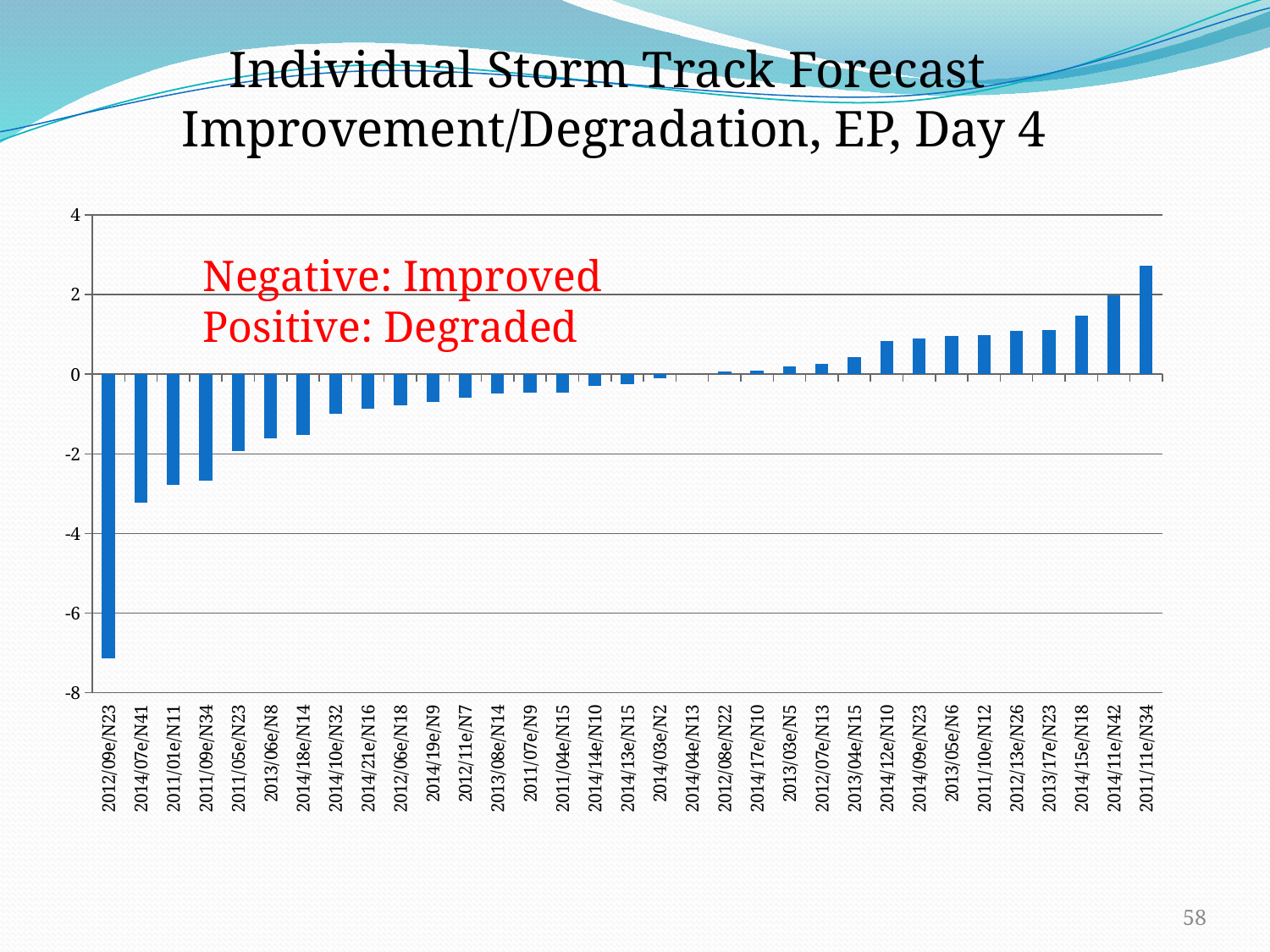
What kind of chart is shown on the slide? bar chart Is the value for 2013/06e/N8 greater or less than -2? greater Is the value for 2014/07e/N41 greater or less than -2? less Is the value for 2012/09e/N23 greater or less than -6? less Which storm has the lowest (most negative) value? 2012/09e/N23 How many storms (bars) are plotted in the chart? 33 According to the annotation on the chart, what does a negative value indicate? Improved Which storm has the highest (most positive) value? 2011/11e/N34 Which has the lower value, 2012/09e/N23 or 2014/07e/N41? 2012/09e/N23 Do the values rise or fall moving from left to right along the x axis? rise